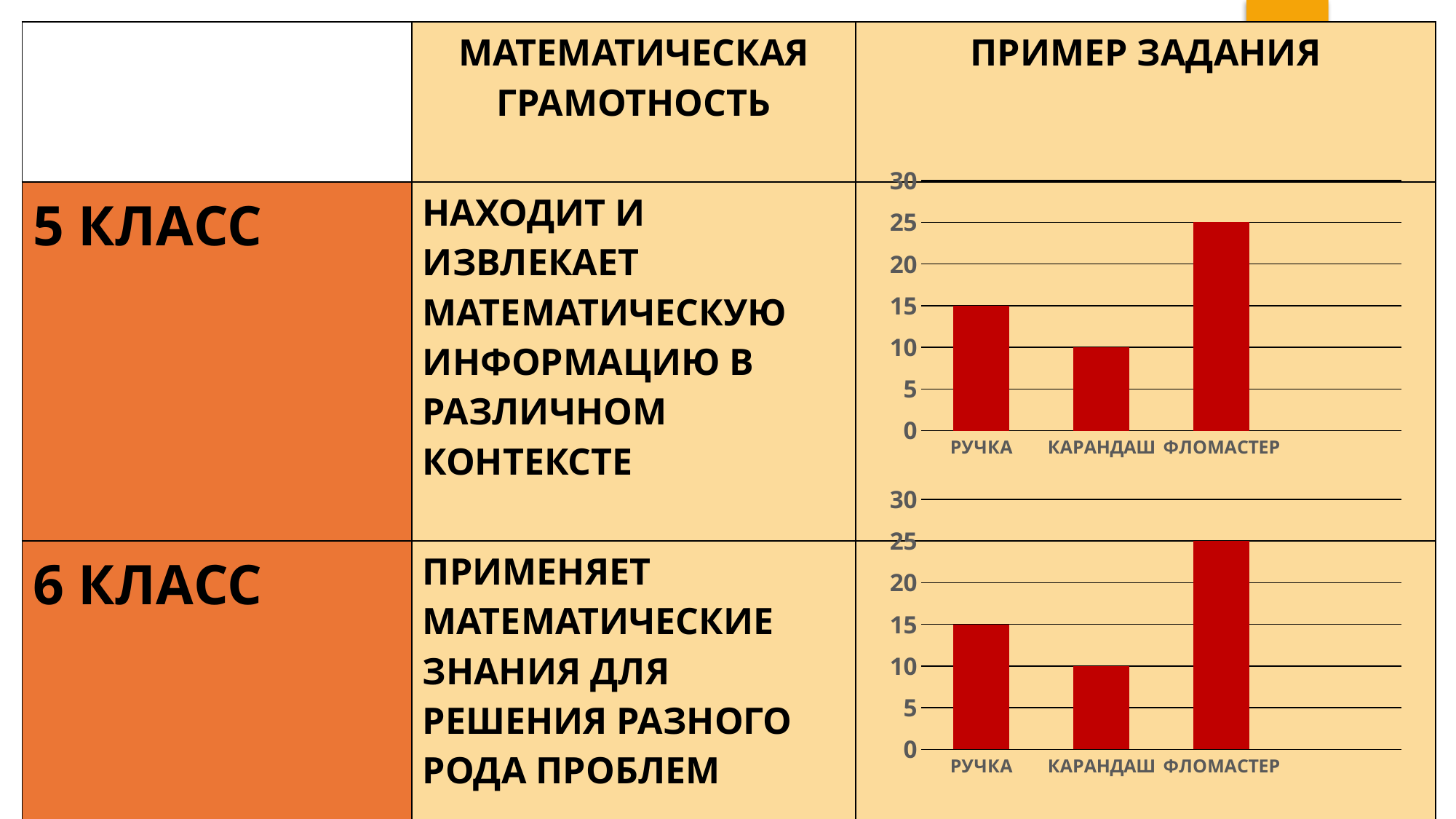
In the bottom chart, which is larger, the value for РУЧКА or the value for КАРАНДАШ? РУЧКА In the top chart, what is the value for РУЧКА? 15 In the top chart, what is the difference between the values for ФЛОМАСТЕР and РУЧКА? 10 In the bottom chart, which category has the lowest value? КАРАНДАШ In the top chart, what is the value for ФЛОМАСТЕР? 25 In the top chart, is the value for ФЛОМАСТЕР greater or less than 20? greater What kind of chart is the top chart? bar chart In the bottom chart, what is the difference between the values for РУЧКА and КАРАНДАШ? 5 In the bottom chart, what is the value for ФЛОМАСТЕР? 25 In the top chart, which category has the highest value? ФЛОМАСТЕР How many categories are shown in the bottom chart? 3 In the top chart, what is the value for КАРАНДАШ? 10